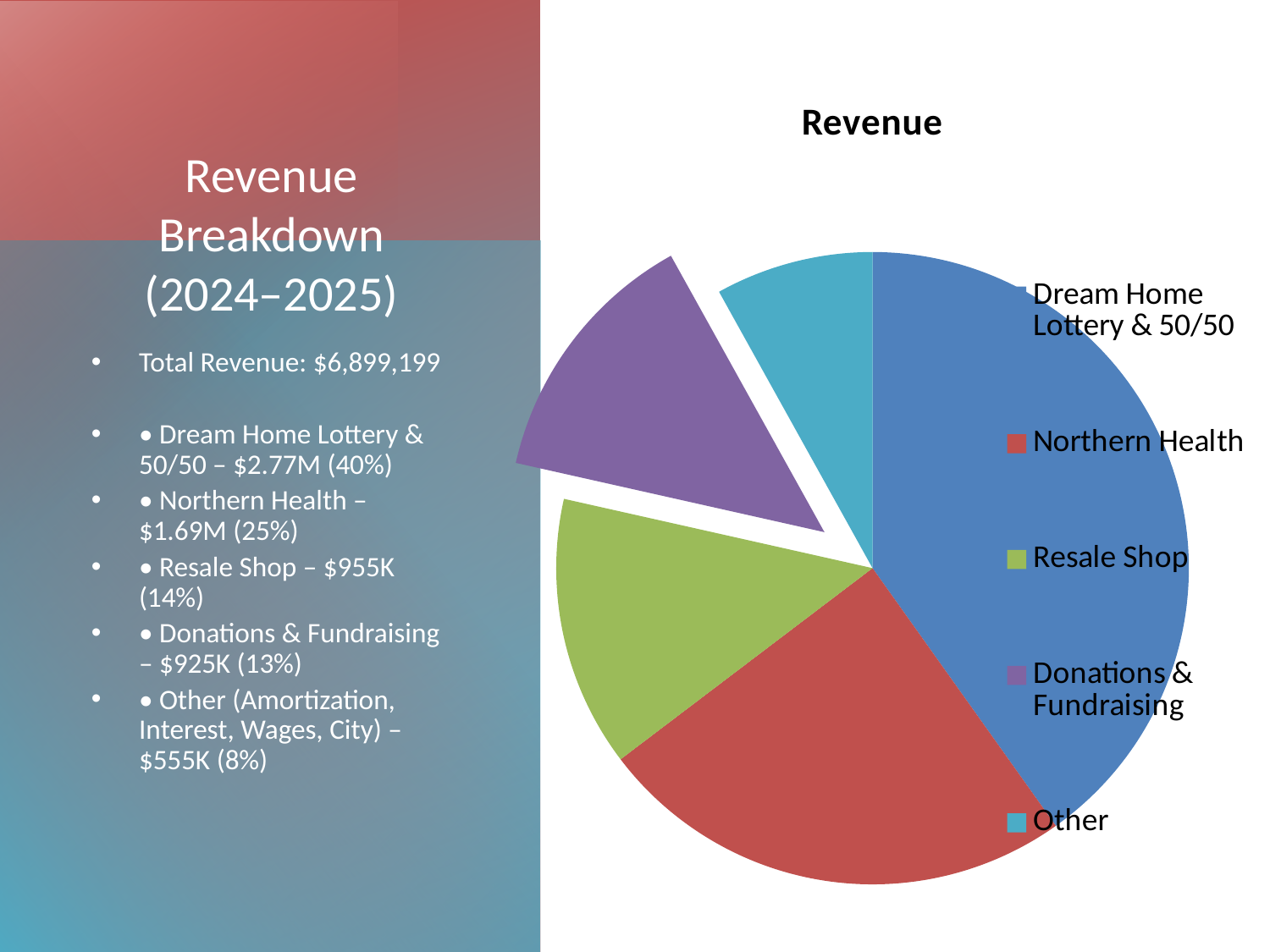
Which slice is larger, Other or Donations & Fundraising? Donations & Fundraising Which slice is pulled out (exploded) from the rest of the pie? Donations & Fundraising How many slices does the pie chart have? 5 Which category has the smallest slice of the pie? Other What is the title of the chart? Revenue How many entries does the chart legend list? 5 What kind of chart is shown on the slide? Pie chart What share of revenue does the Other slice represent, according to the slide? 8% What share of revenue does the Northern Health slice represent, according to the slide? 25% What share of revenue does the Dream Home Lottery & 50/50 slice represent, according to the slide? 40% Which slice is larger, Northern Health or Resale Shop? Northern Health Which category has the largest slice of the pie? Dream Home Lottery & 50/50